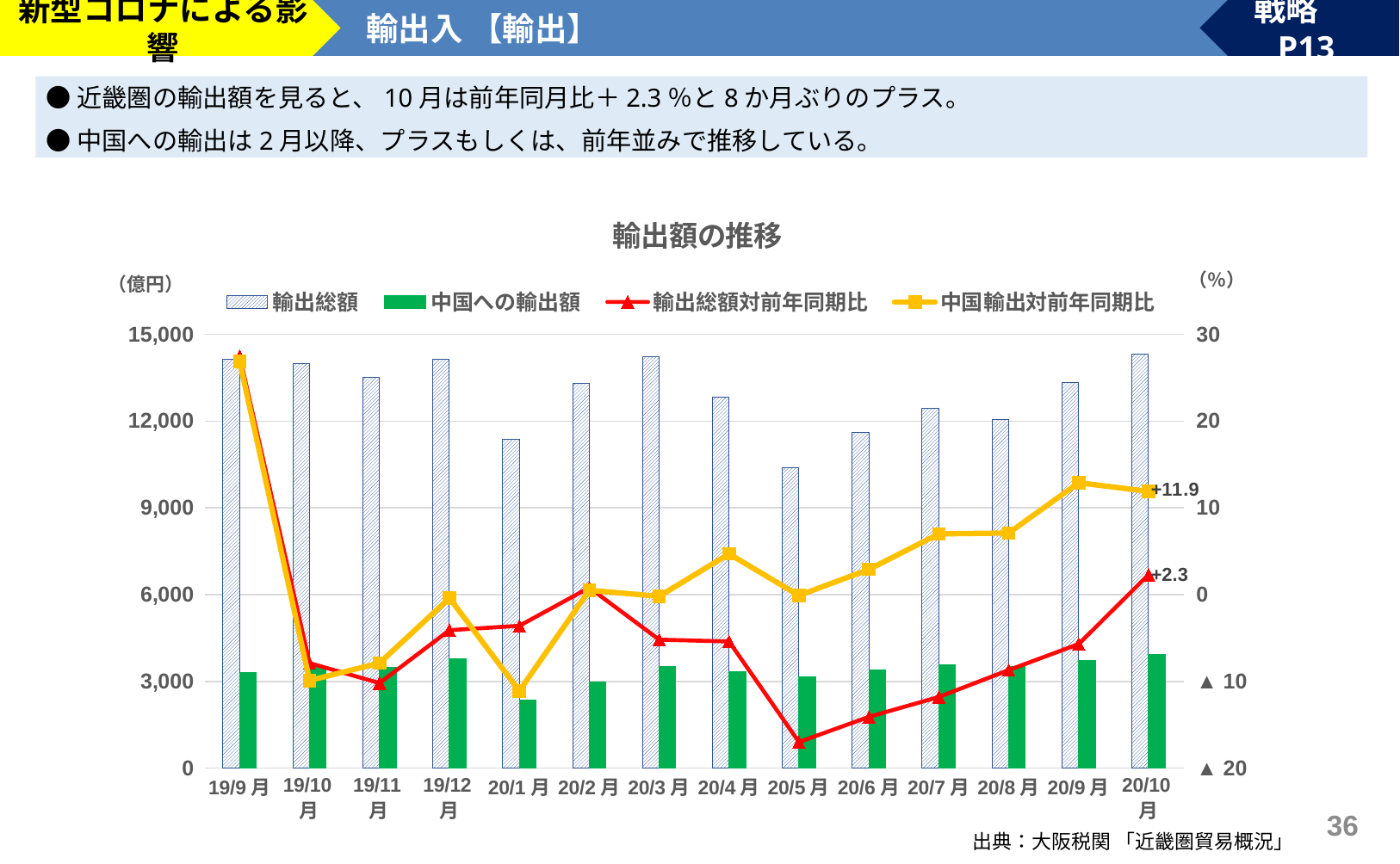
In the chart 輸出額の推移, which is larger, the 輸出総額 for 20/10月 or for 20/5月? 20/10月 In the chart 輸出額の推移, what is the value of 中国輸出対前年同期比 for 20/10月? +11.9 What kind of chart is 輸出額の推移? A combined bar and line chart How many series does the legend of the chart 輸出額の推移 list? 4 In the chart 輸出額の推移, is the 輸出総額 value for 19/9月 greater or less than 12,000? greater In the chart 輸出額の推移, which month has the lowest 輸出総額 bar? 20/5月 In the chart 輸出額の推移, what is the value of 輸出総額対前年同期比 for 20/10月? +2.3 How many months are shown on the x axis of the chart 輸出額の推移? 14 In the chart 輸出額の推移, which month has the lowest 中国への輸出額 bar? 20/1月 In the chart 輸出額の推移, in which month does the 輸出総額対前年同期比 line reach its lowest point? 20/5月 What unit is shown on the left vertical axis of the chart 輸出額の推移? 億円 In the chart 輸出額の推移, is the 輸出総額 value for 20/5月 greater or less than 12,000? less